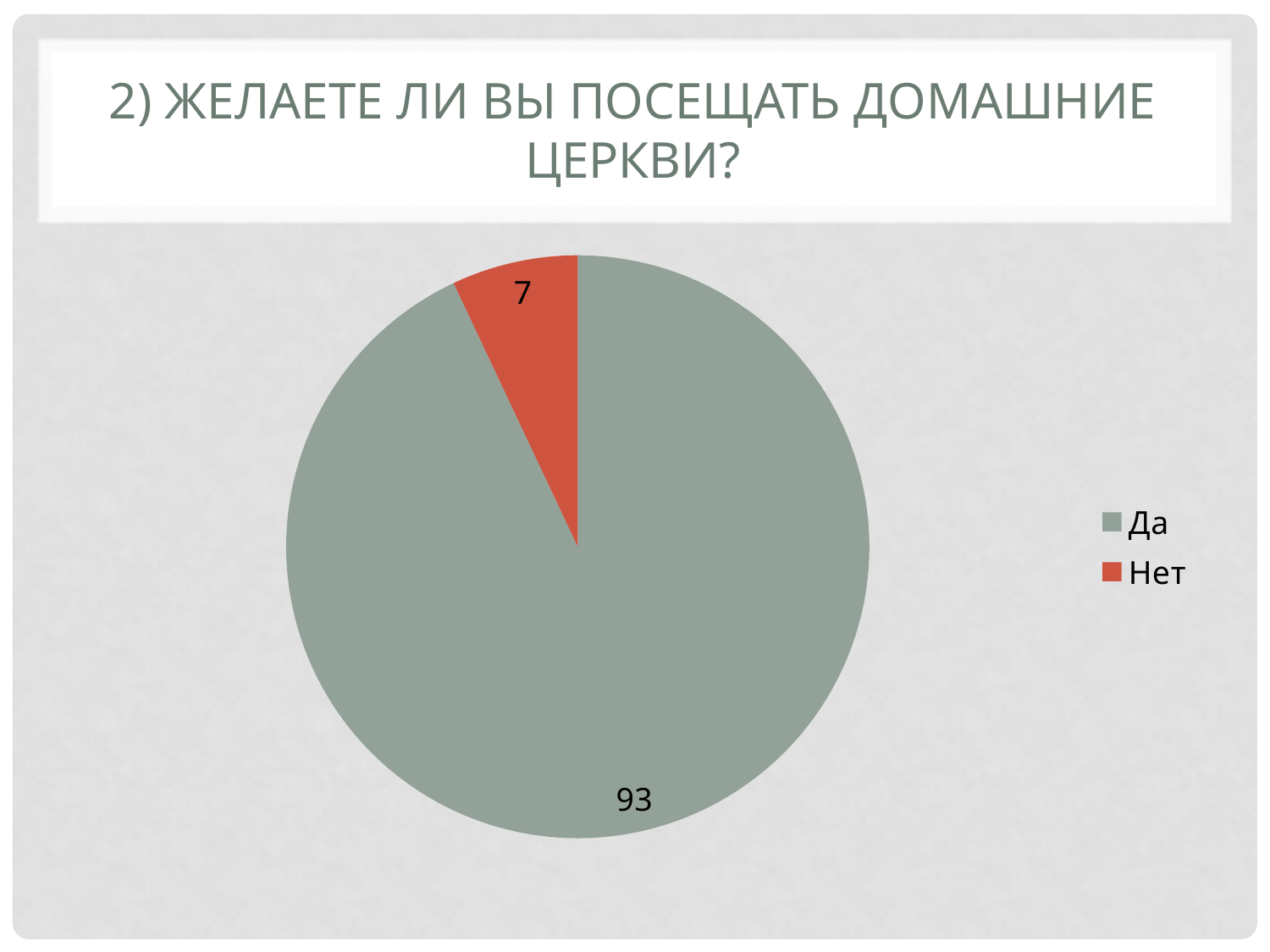
What colour is the "Нет" slice in the pie chart? Red What is the difference between the values for "Да" and "Нет"? 86 What is the value for "Да" in the pie chart? 93 What share of the pie does the "Нет" slice represent? 7% What is the value for "Нет" in the pie chart? 7 What kind of chart is shown on the slide? Pie chart Which category has the largest slice in the pie chart? Да What is the title of the slide containing the pie chart? 2) Желаете ли вы посещать домашние церкви? Which category has the smallest slice in the pie chart? Нет What is the total of the two values shown in the pie chart? 100 Which is larger, the value for "Да" or the value for "Нет"? Да How many categories does the pie chart show? 2